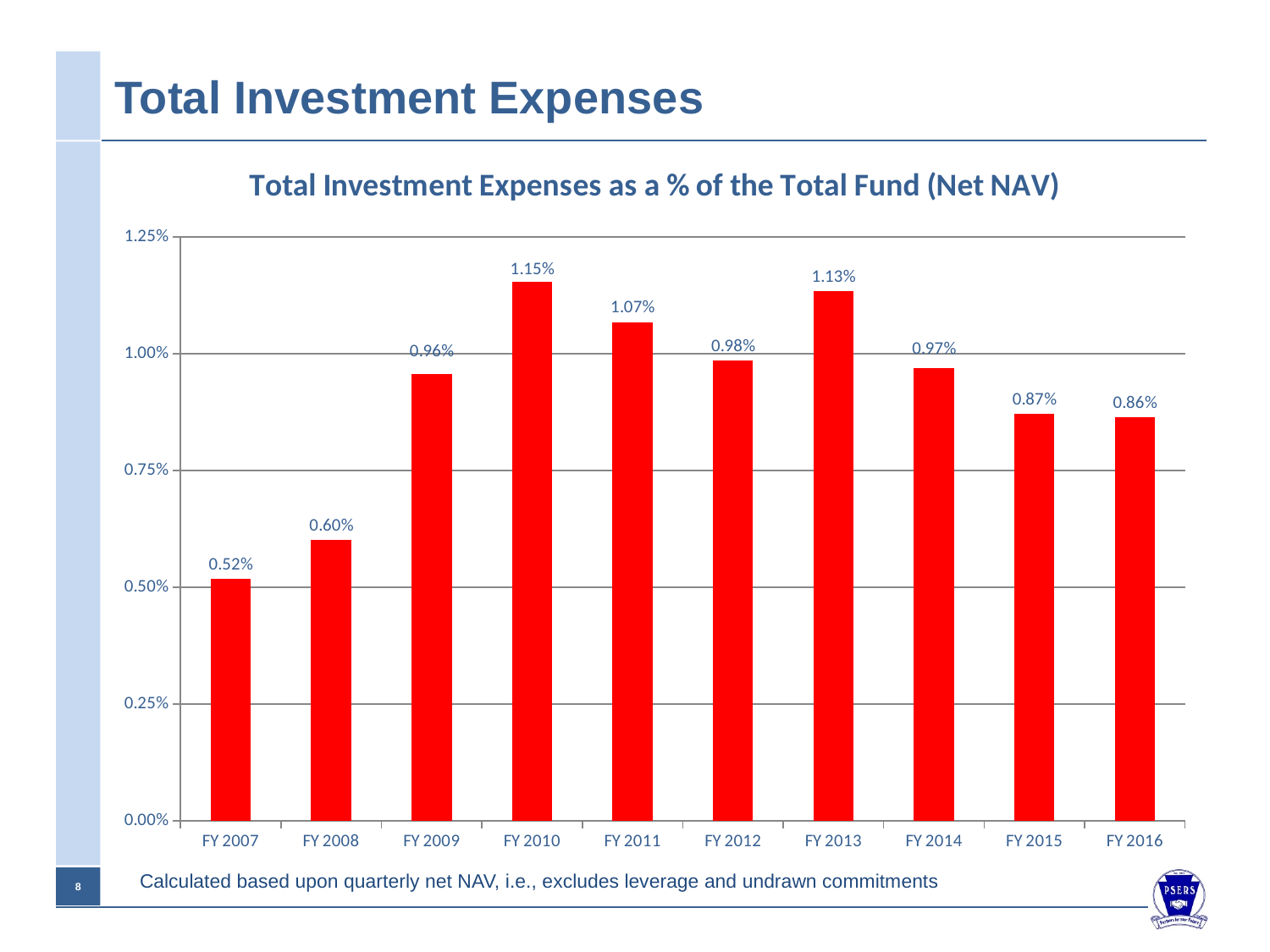
What is the title of the chart? Total Investment Expenses as a % of the Total Fund (Net NAV) What is the difference between the values for FY 2010 and FY 2007? 0.63% What is the value for FY 2007? 0.52% Which fiscal year has the highest value? FY 2010 How many fiscal years are shown on the x axis? 10 What kind of chart is shown on the slide? bar chart What is the value for FY 2014? 0.97% Which fiscal year has the lowest value? FY 2007 Is the value for FY 2008 greater or less than 0.75%? less Which is larger, the value for FY 2011 or the value for FY 2012? FY 2011 What is the value for FY 2010? 1.15% What is the difference between the values for FY 2013 and FY 2016? 0.27%